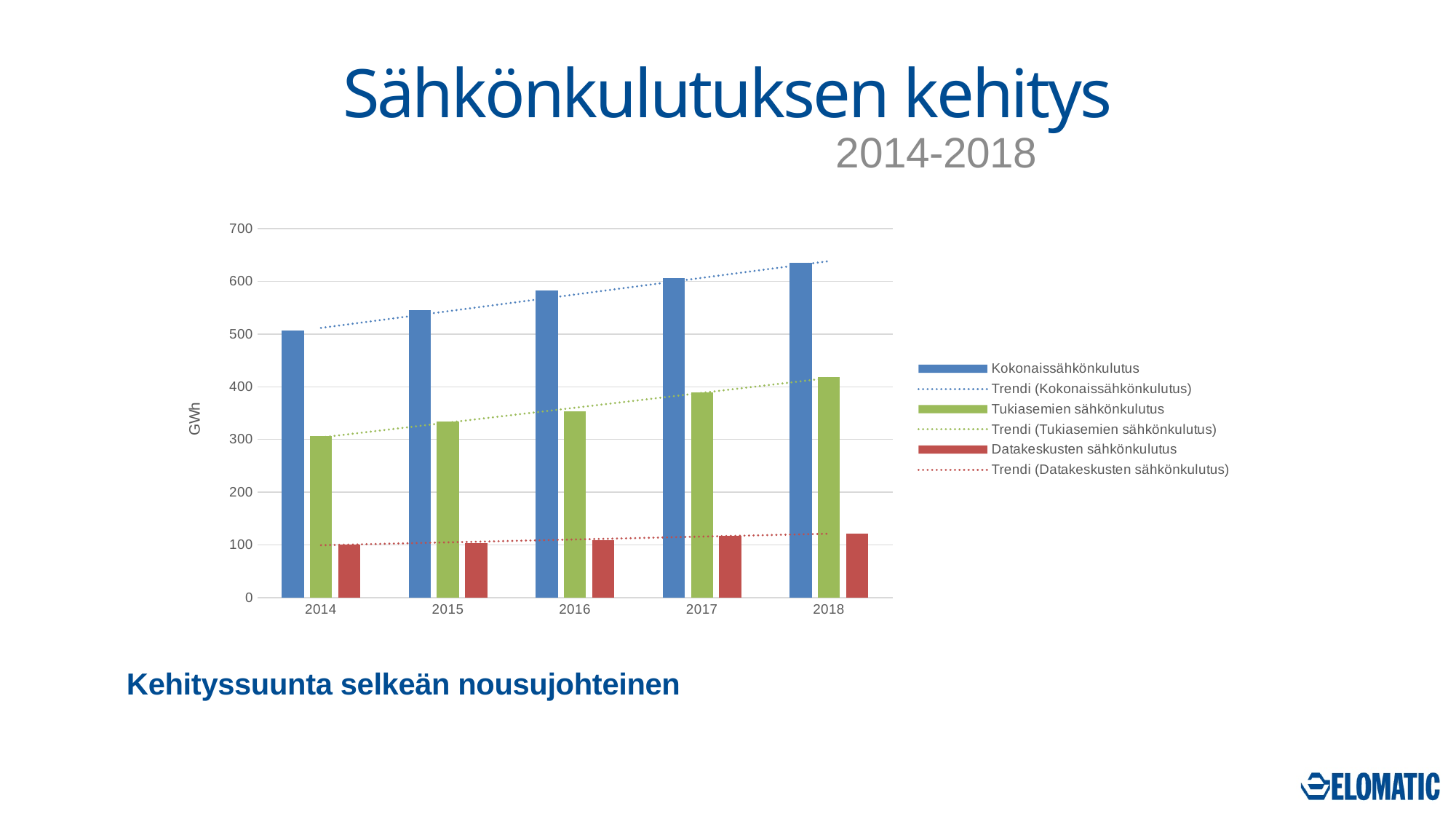
Do the values for Kokonaissähkönkulutus rise or fall from 2014 to 2018? rise Is the value for Kokonaissähkönkulutus in 2018 greater or less than 600? greater Is the value for Tukiasemien sähkönkulutus in 2016 greater or less than 400? less Which is larger in 2017, Kokonaissähkönkulutus or Datakeskusten sähkönkulutus? Kokonaissähkönkulutus Is the value for Kokonaissähkönkulutus in 2016 greater or less than 600? less In which year is Tukiasemien sähkönkulutus lowest? 2014 What unit is shown on the chart's y axis? GWh How many entries does the chart's legend list? 6 In which year is Kokonaissähkönkulutus highest? 2018 What kind of chart is shown on the slide? bar chart How many years are shown on the x axis of the chart? 5